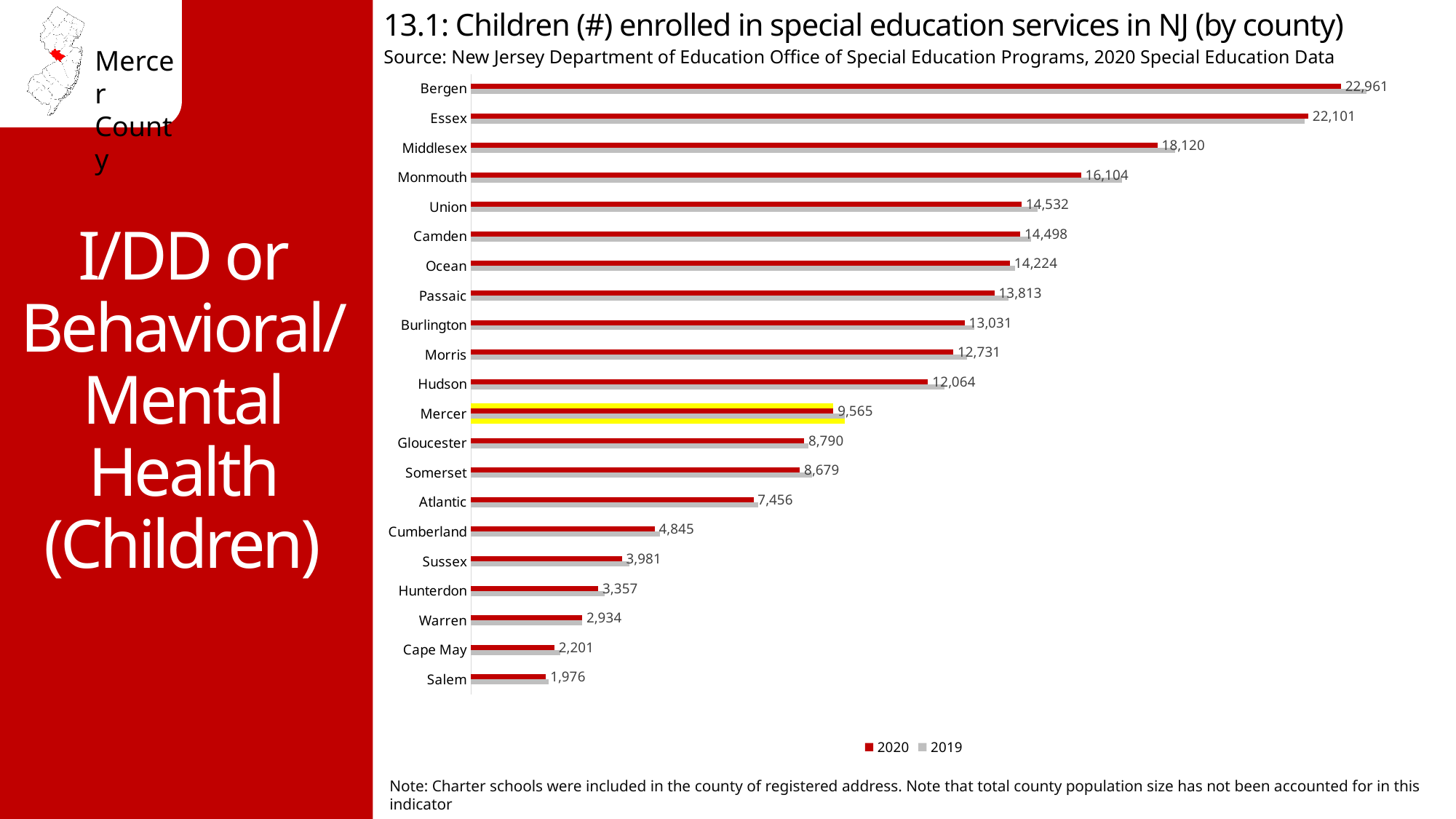
Which has a larger 2020 value, Middlesex or Monmouth? Middlesex What is the 2020 value for Bergen County? 22,961 What kind of chart is shown? Bar chart Which county has the lowest 2020 value? Salem Which county's bars are highlighted in yellow? Mercer What is the difference between the 2020 values for Mercer and Gloucester? 775 What is the difference between the 2020 values for Bergen and Essex? 860 Which county has the highest 2020 value? Bergen How many counties are shown in the chart? 21 How many series does the legend list? 2 What is the 2020 value for Mercer County? 9,565 What is the 2020 value for Cumberland County? 4,845